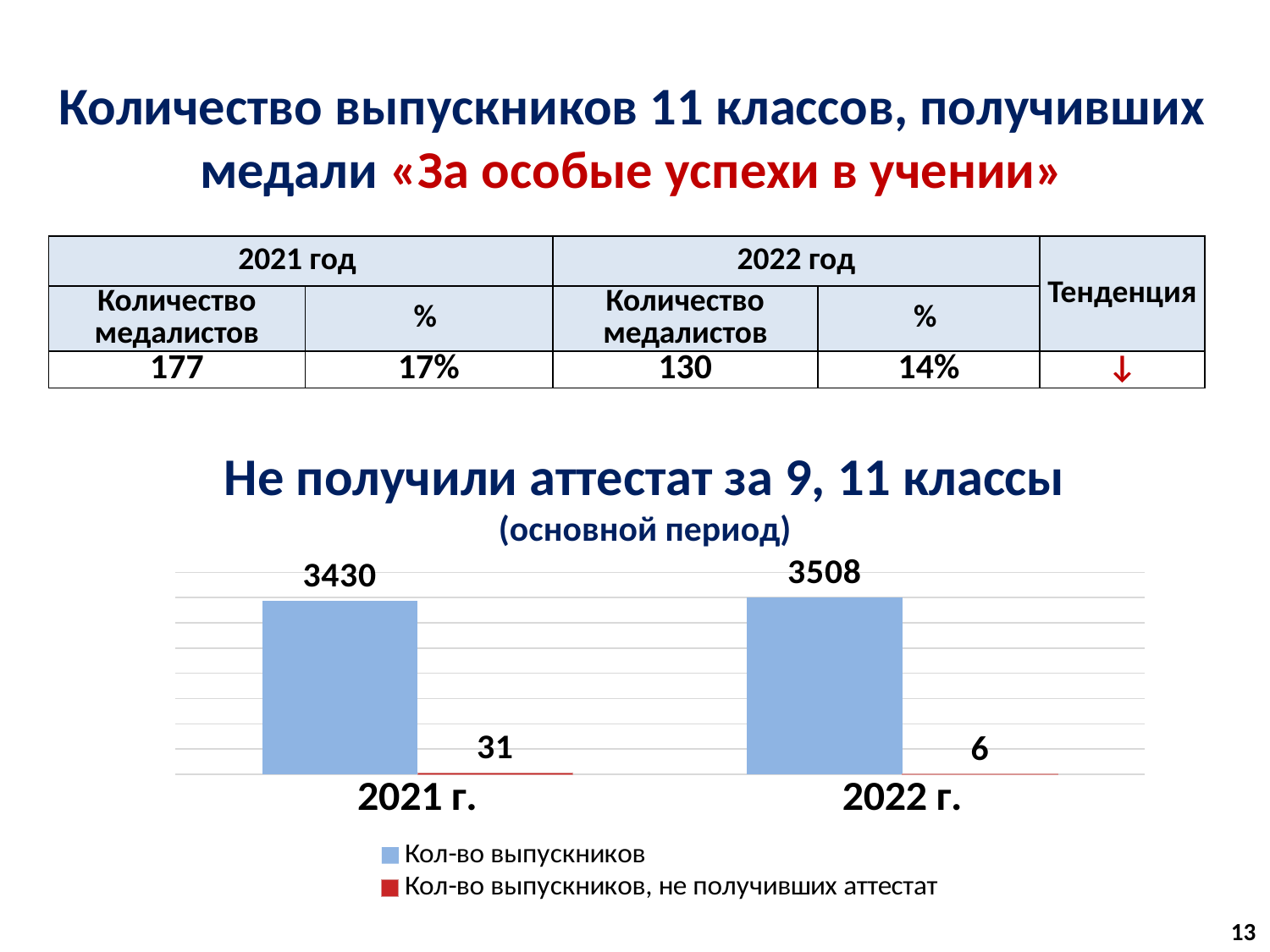
What is the value for 'Кол-во выпускников, не получивших аттестат' in 2021 г.? 31 Is the value for 'Кол-во выпускников, не получивших аттестат' larger in 2021 г. or 2022 г.? 2021 г. Does the value for 'Кол-во выпускников, не получивших аттестат' rise or fall from 2021 г. to 2022 г.? fall What is the difference between the 'Кол-во выпускников' values for 2022 г. and 2021 г.? 78 Which year has the higher value for 'Кол-во выпускников'? 2022 г. What is the value for 'Кол-во выпускников' in 2022 г.? 3508 What is the difference between the 'Кол-во выпускников, не получивших аттестат' values for 2021 г. and 2022 г.? 25 Which year has the lower value for 'Кол-во выпускников, не получивших аттестат'? 2022 г. What is the value for 'Кол-во выпускников' in 2021 г.? 3430 What kind of chart is shown on the slide? bar chart How many series does the chart legend list? 2 What is the value for 'Кол-во выпускников, не получивших аттестат' in 2022 г.? 6